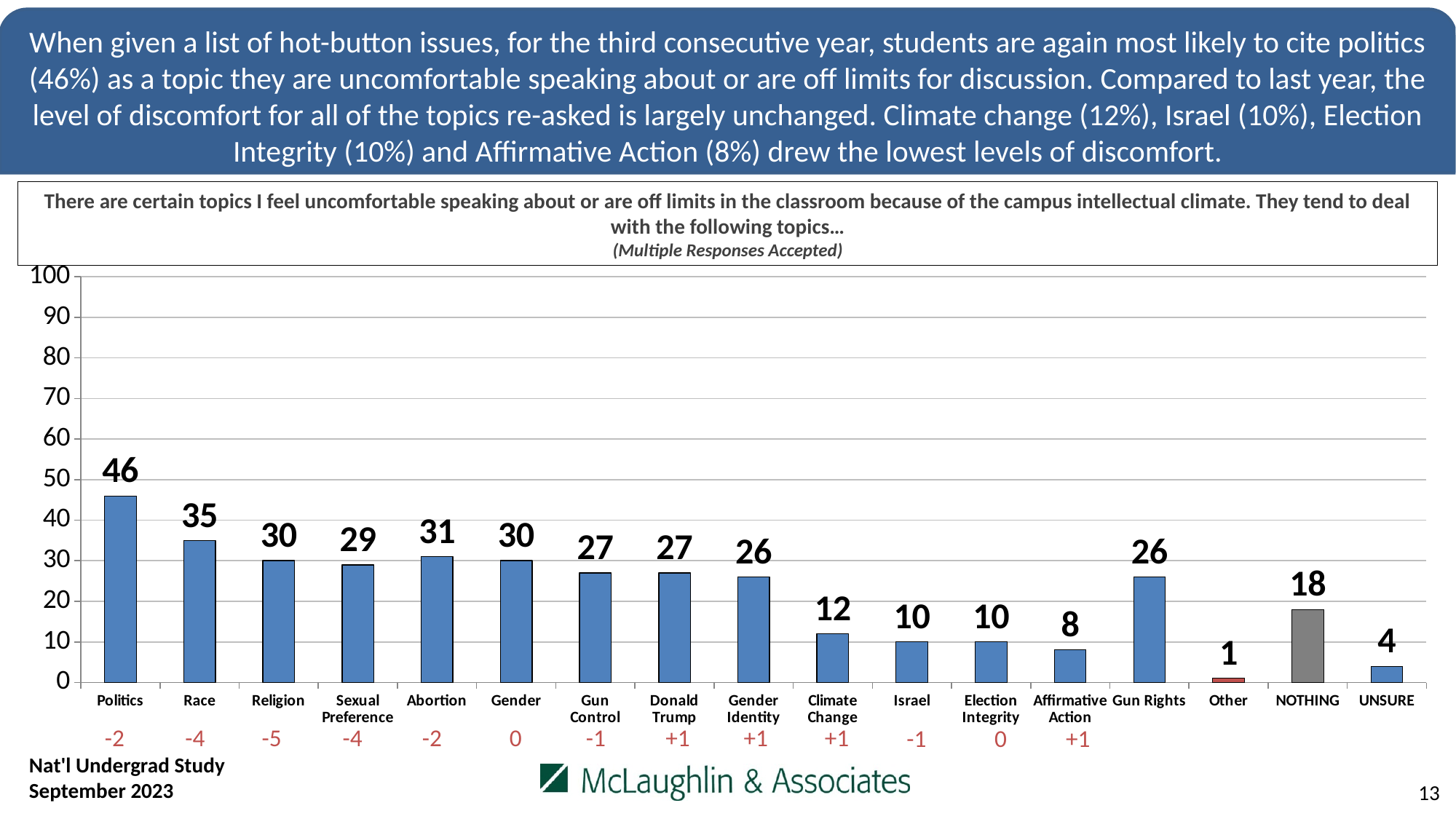
What kind of chart is shown on the slide? bar chart What is the red number shown below the Religion bar? -5 Which category has the highest value? Politics What is the value for Politics? 46 What is the value for NOTHING? 18 Is the value for Gun Rights greater or less than 20? greater How many categories are shown on the x axis? 17 Which category has the lowest value? Other What is the difference between the values for Politics and Race? 11 What is the difference between the values for Climate Change and Affirmative Action? 4 Which is larger, the value for Abortion or the value for Sexual Preference? Abortion What is the value for Gender Identity? 26